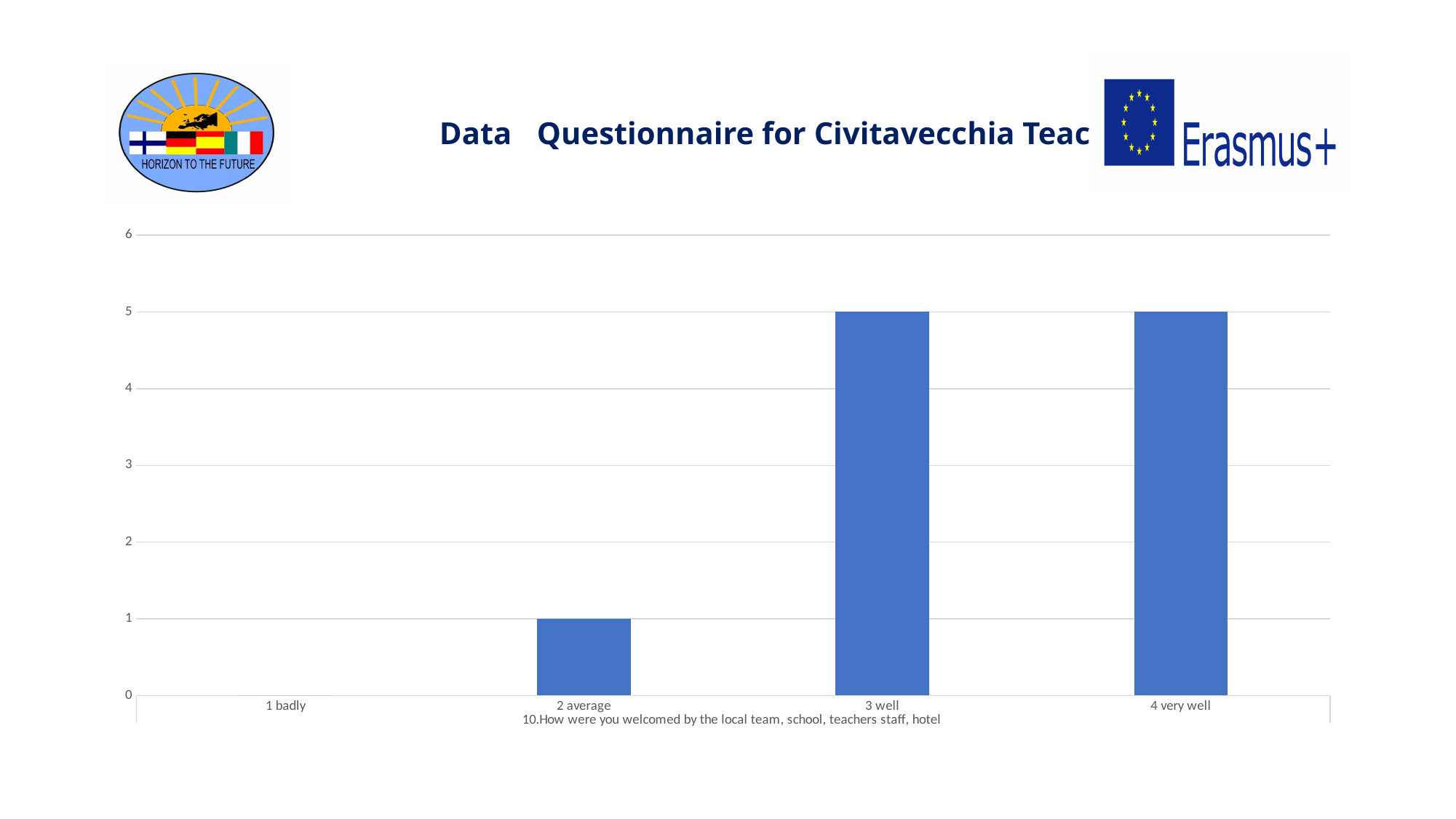
What is the value for "3 well"? 5 Which category has the lowest value? 1 badly What question is written below the x axis of the chart? 10.How were you welcomed by the local team, school, teachers staff, hotel What is the difference between the values for "3 well" and "2 average"? 4 Which is larger, the value for "3 well" or the value for "2 average"? 3 well How many categories are shown on the x axis? 4 What is the value for "4 very well"? 5 What is the value for "2 average"? 1 What is the value for "1 badly"? 0 What kind of chart is shown on the slide? bar chart Is the value for "2 average" greater or less than 2? less Is the value for "4 very well" greater or less than 4? greater